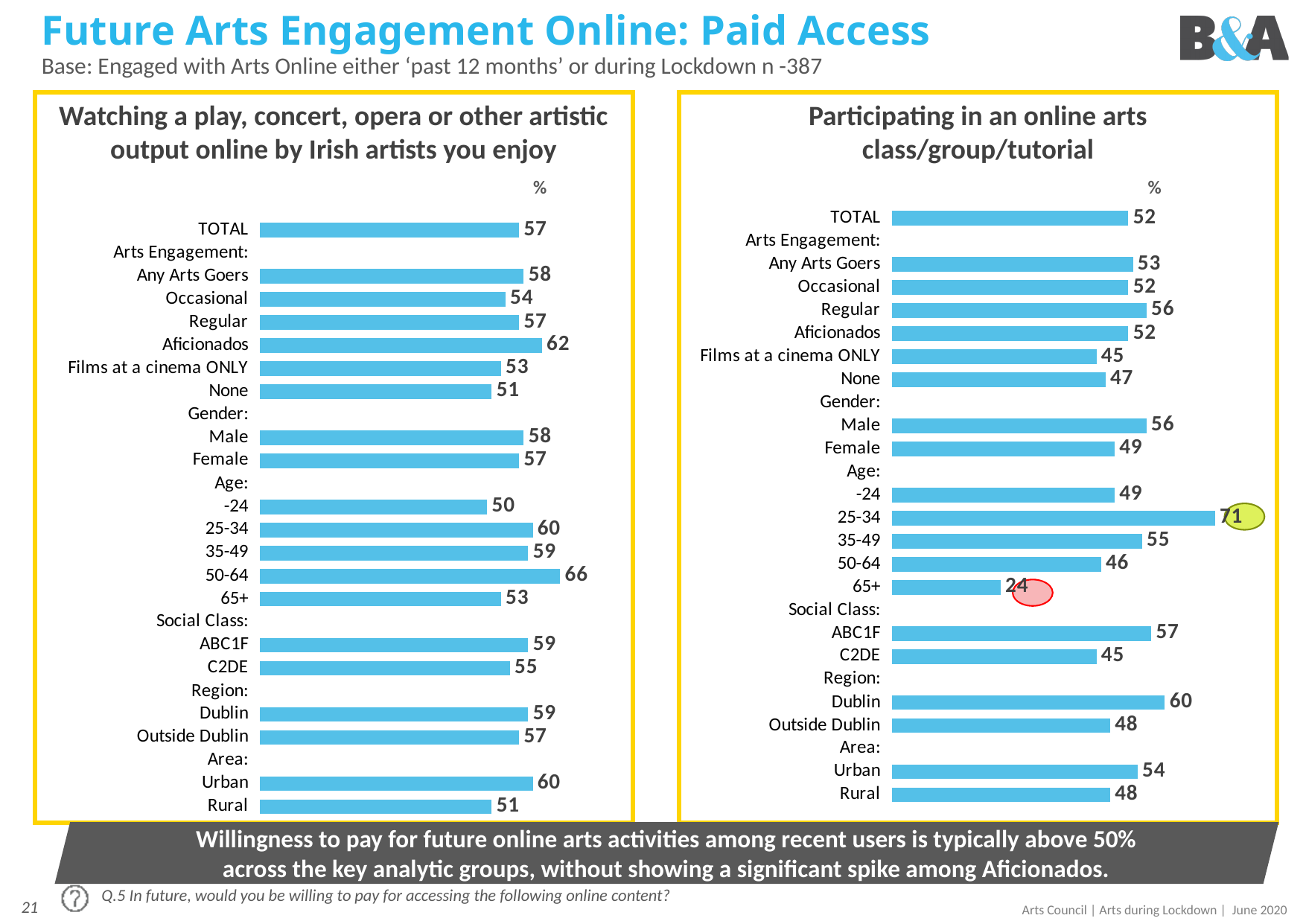
In the left chart (Watching a play, concert, opera or other artistic output online by Irish artists you enjoy), what is the value for TOTAL? 57 What is the title of the right-hand chart? Participating in an online arts class/group/tutorial In the right chart (Participating in an online arts class/group/tutorial), what is the difference between Dublin and Outside Dublin? 12 In the right chart (Participating in an online arts class/group/tutorial), which category has the highest value? 25-34 In the left chart (Watching a play, concert, opera or other artistic output online), which is larger, Aficionados or Occasional? Aficionados What kind of chart is used in the left panel (Watching a play, concert, opera or other artistic output online)? Bar chart In the right chart (Participating in an online arts class/group/tutorial), what is the value for ABC1F? 57 In the right chart (Participating in an online arts class/group/tutorial), which is larger, Male or Female? Male In the right chart (Participating in an online arts class/group/tutorial), which category has the lowest value? 65+ In the right chart (Participating in an online arts class/group/tutorial), what is the value for 65+? 24 In the left chart (Watching a play, concert, opera or other artistic output online), what is the difference between Urban and Rural? 9 In the left chart (Watching a play, concert, opera or other artistic output online), which category has the highest value? 50-64